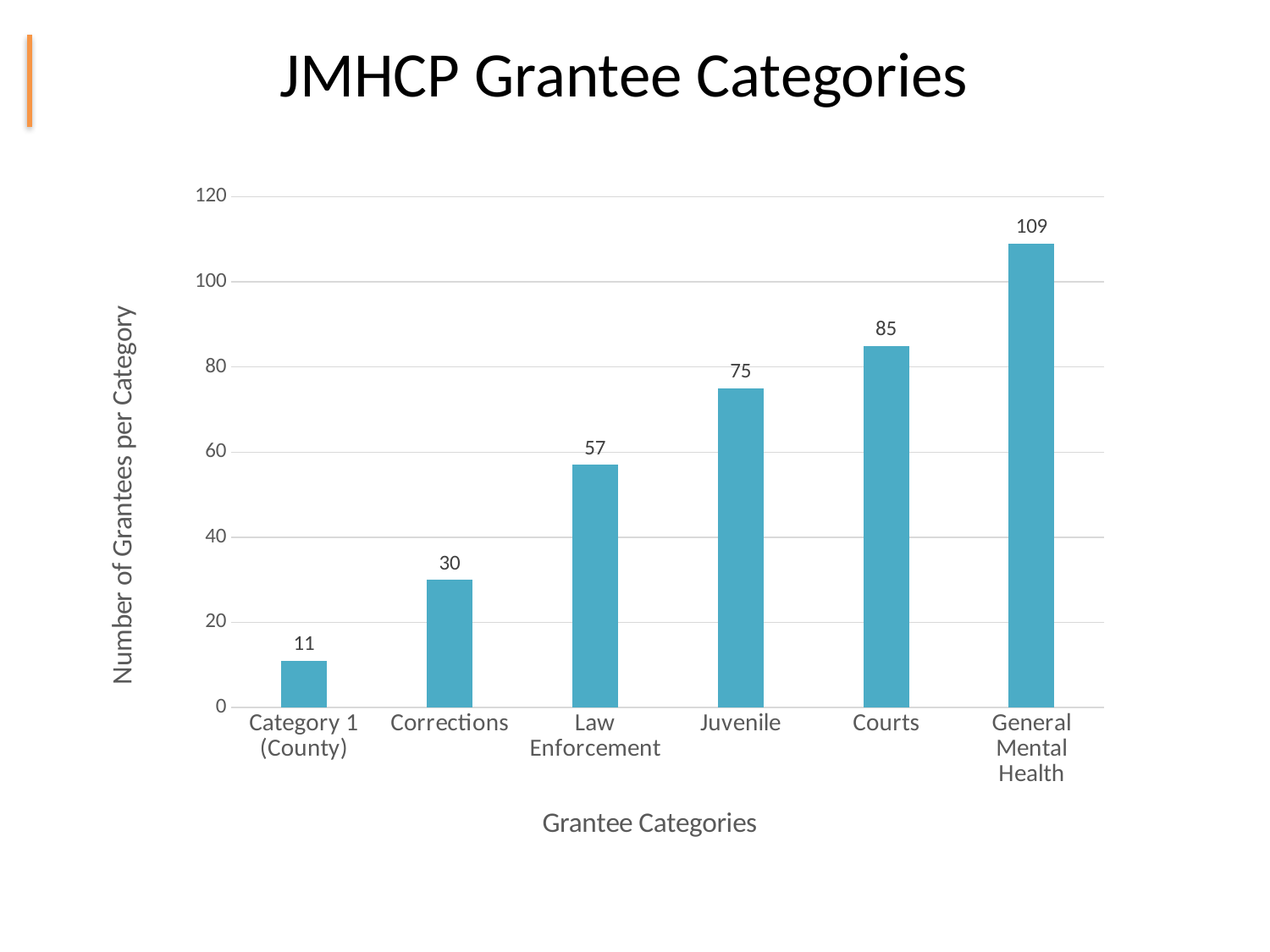
Do the values rise or fall from left to right along the x axis? Rise What is the value for the Courts category? 85 How many grantees are in the Corrections category? 30 What is the difference between the Courts and Corrections values? 55 Is the value for Courts greater or less than 80? greater Which has more grantees, Juvenile or Law Enforcement? Juvenile Which grantee category has the highest number of grantees? General Mental Health Which grantee category has the lowest number of grantees? Category 1 (County) What is the difference in number of grantees between General Mental Health and Juvenile? 34 What is the number of grantees for Law Enforcement? 57 What kind of chart is shown on the slide? Bar chart How many grantee categories are shown on the chart? 6